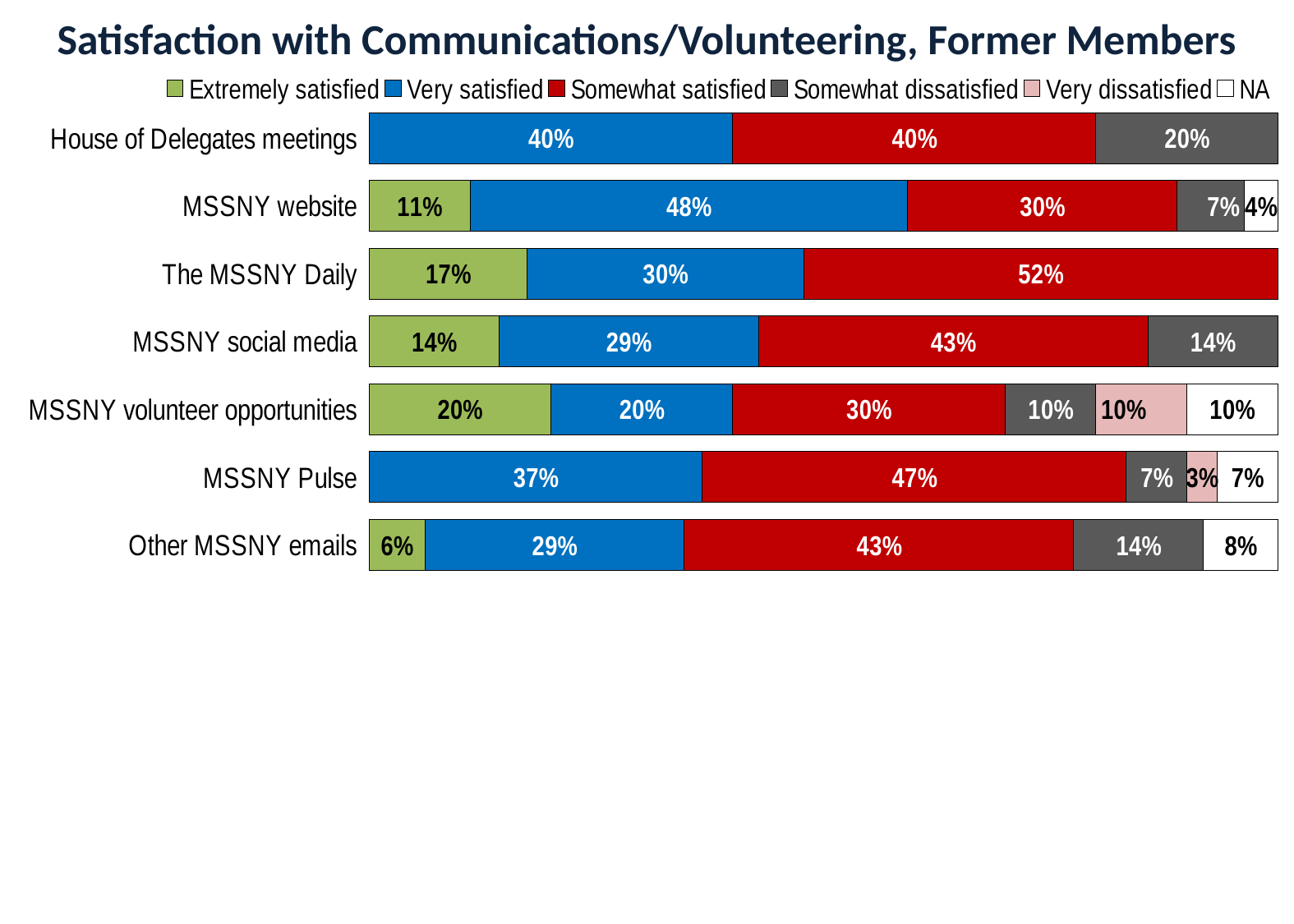
What is the Somewhat satisfied value for The MSSNY Daily? 52% Which is larger: the Somewhat dissatisfied value for House of Delegates meetings or for MSSNY social media? House of Delegates meetings What is the Very dissatisfied value for MSSNY Pulse? 3% What type of chart is shown on the slide? Stacked bar chart How many series does the legend list? 6 What is the title of the chart? Satisfaction with Communications/Volunteering, Former Members Which category has the highest Extremely satisfied value? MSSNY volunteer opportunities Which category has the highest Very satisfied value? MSSNY website What is the difference between the Somewhat satisfied values for MSSNY Pulse and MSSNY volunteer opportunities? 17% What is the NA value for Other MSSNY emails? 8% What is the Very satisfied value for MSSNY website? 48% How many categories are plotted on the chart? 7